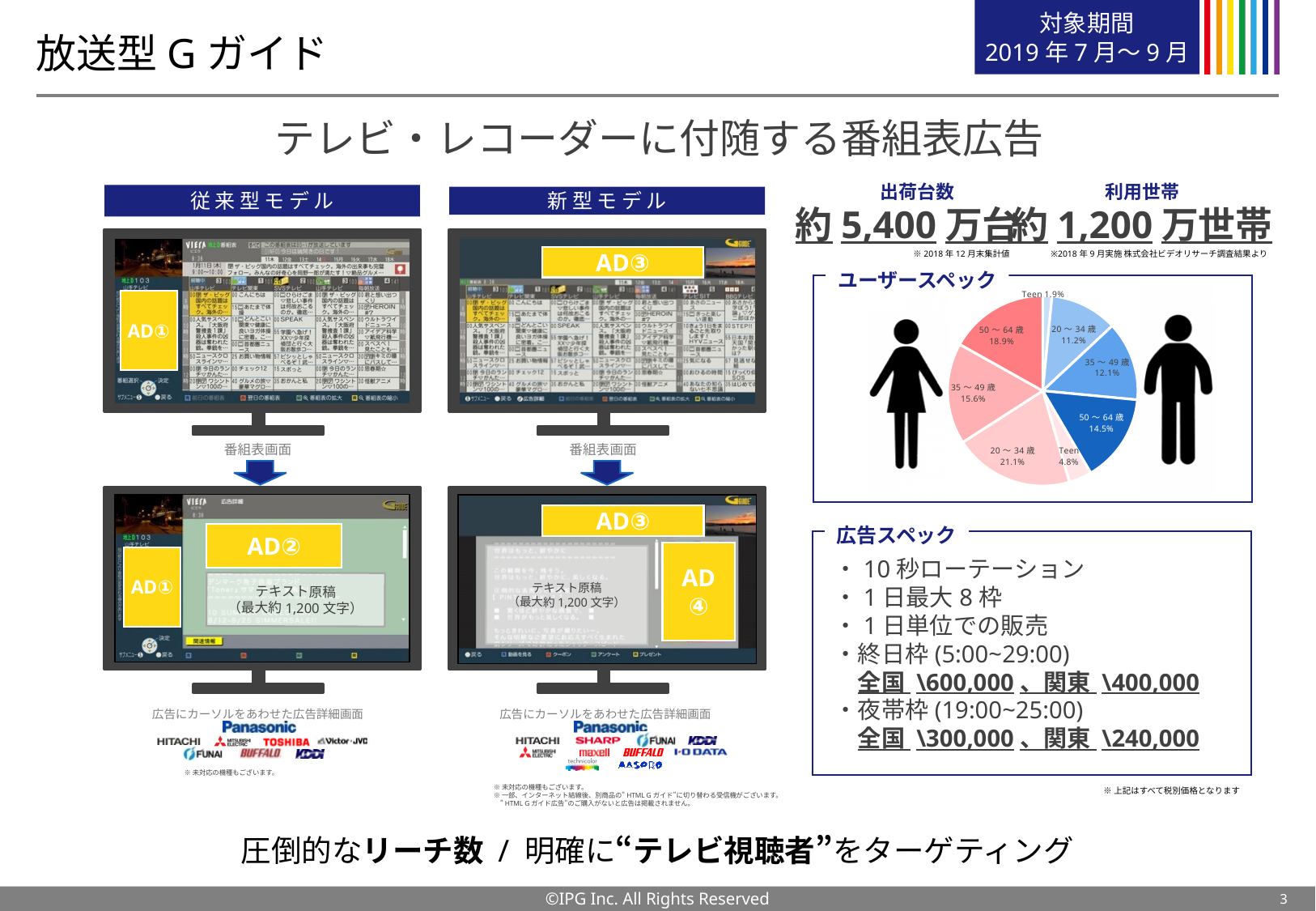
In the ユーザースペック pie chart, which slice has the largest share? female (pink) 20～34歳, 21.1% In the ユーザースペック pie chart, what is the difference between the female (pink) 35～49歳 slice and the male (blue) 35～49歳 slice? 3.5% In the ユーザースペック pie chart, what is the share of the female (pink) 50～64歳 slice? 18.9% In the ユーザースペック pie chart, which is larger: the male (blue) 20～34歳 slice or the female (pink) 20～34歳 slice? female (pink) 20～34歳 In the ユーザースペック pie chart, what is the share of the male (blue) Teen slice? 1.9% In the ユーザースペック pie chart, what is the share of the female (pink) 20～34歳 slice? 21.1% In the ユーザースペック pie chart, what is the share of the male (blue) 50～64歳 slice? 14.5% How many slices does the ユーザースペック pie chart have? 8 What is the title of the section containing the pie chart? ユーザースペック In the ユーザースペック pie chart, which slice has the smallest share? male (blue) Teen, 1.9% In the ユーザースペック pie chart, what is the share of the female (pink) Teen slice? 4.8% What kind of chart is shown in the ユーザースペック section? pie chart